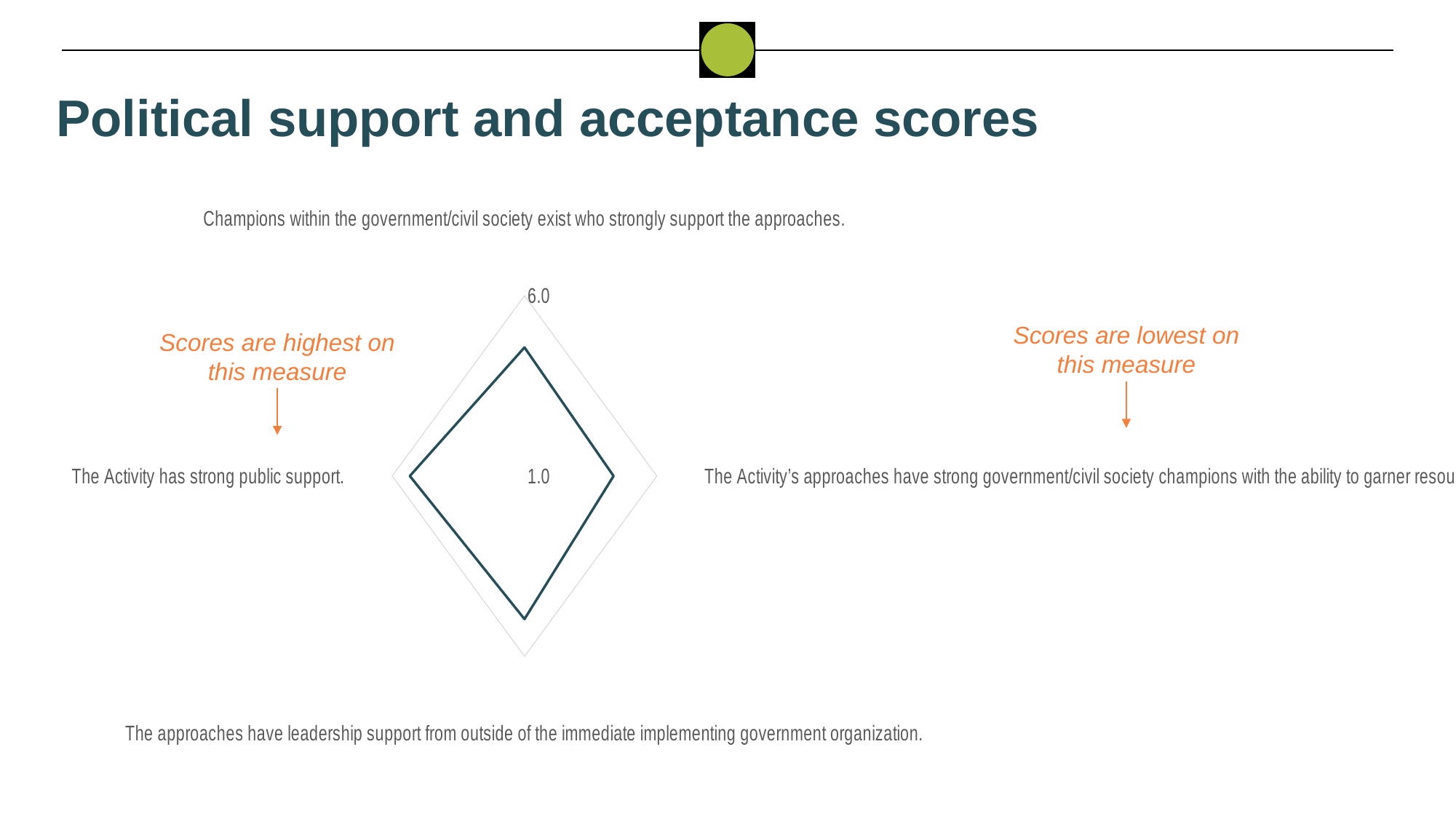
What does the orange annotation on the right side of the chart say? Scores are lowest on this measure How many measures (axes) does the radar chart have? 4 What kind of chart is shown on the slide? radar chart Is the value for "The Activity has strong public support." greater or less than 6.0? less Is the value for "The Activity has strong public support." greater or less than 1.0? greater Is the value for "The approaches have leadership support from outside of the immediate implementing government organization." greater or less than 1.0? greater On which measure are scores highest, according to the chart annotation? The Activity has strong public support. Which has the larger score: "The Activity has strong public support." or "The approaches have leadership support from outside of the immediate implementing government organization."? The Activity has strong public support. What is the title of the slide containing the radar chart? Political support and acceptance scores